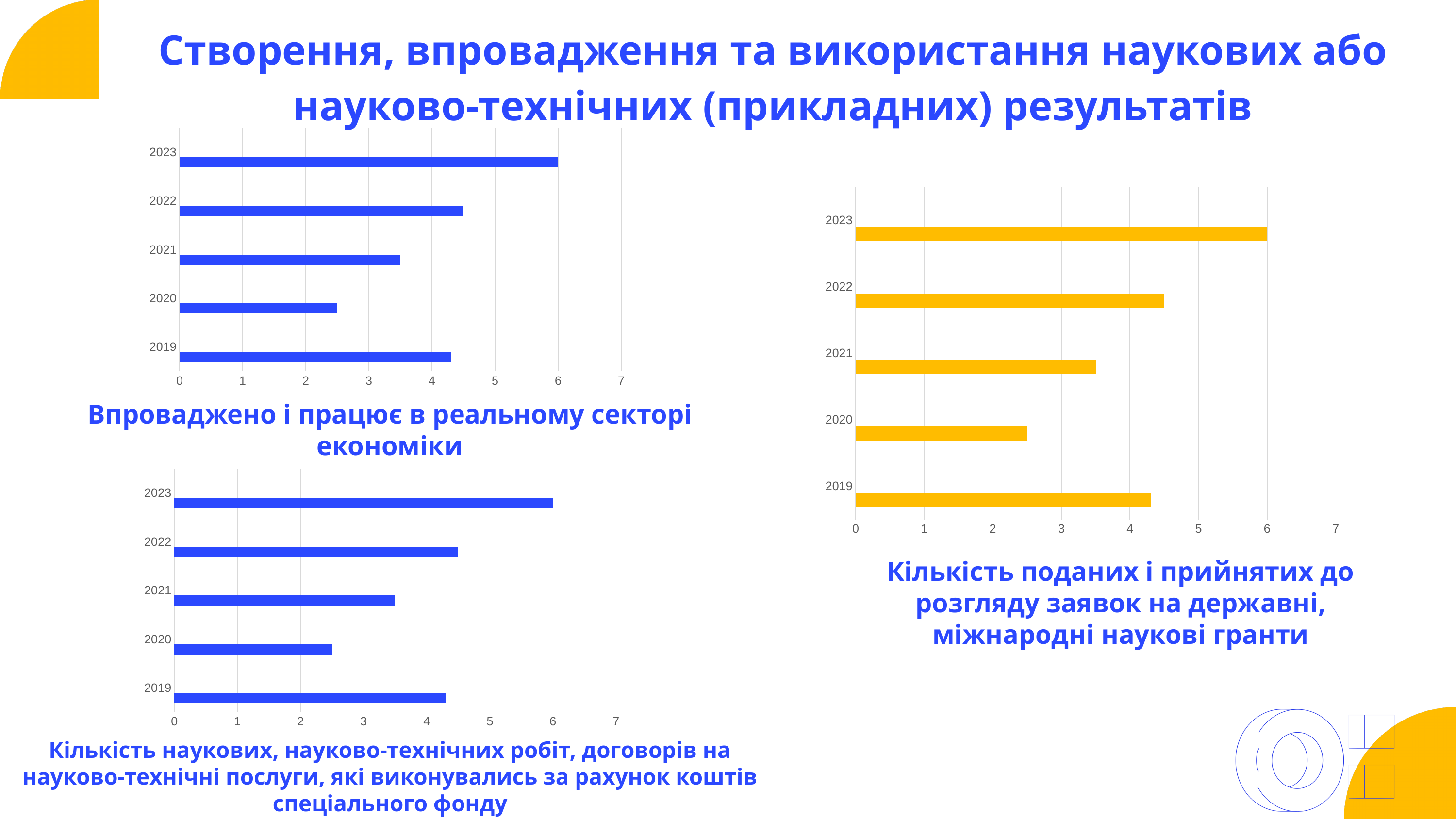
In the top-left chart "Впроваджено і працює в реальному секторі економіки", is the value for 2020 greater or less than 3? less In the bottom-left chart "Кількість наукових, науково-технічних робіт, договорів на науково-технічні послуги...", is the value for 2021 greater or less than 4? less In the right-hand chart "Кількість поданих і прийнятих до розгляду заявок на державні, міжнародні наукові гранти", which is larger, the value for 2019 or the value for 2021? 2019 How many charts are shown on the slide? 3 In the bottom-left chart "Кількість наукових, науково-технічних робіт, договорів на науково-технічні послуги...", which year has the lowest value? 2020 In the top-left chart "Впроваджено і працює в реальному секторі економіки", which year has the highest value? 2023 What colour are the bars in the right-hand chart "Кількість поданих і прийнятих до розгляду заявок на державні, міжнародні наукові гранти"? yellow How many years are shown in the top-left chart "Впроваджено і працює в реальному секторі економіки"? 5 In the right-hand chart "Кількість поданих і прийнятих до розгляду заявок на державні, міжнародні наукові гранти", which year has the highest value? 2023 What type of chart is the top-left chart titled "Впроваджено і працює в реальному секторі економіки"? bar chart In the top-left chart "Впроваджено і працює в реальному секторі економіки", which year has the lowest value? 2020 In the right-hand chart "Кількість поданих і прийнятих до розгляду заявок на державні, міжнародні наукові гранти", is the value for 2022 greater or less than 4? greater